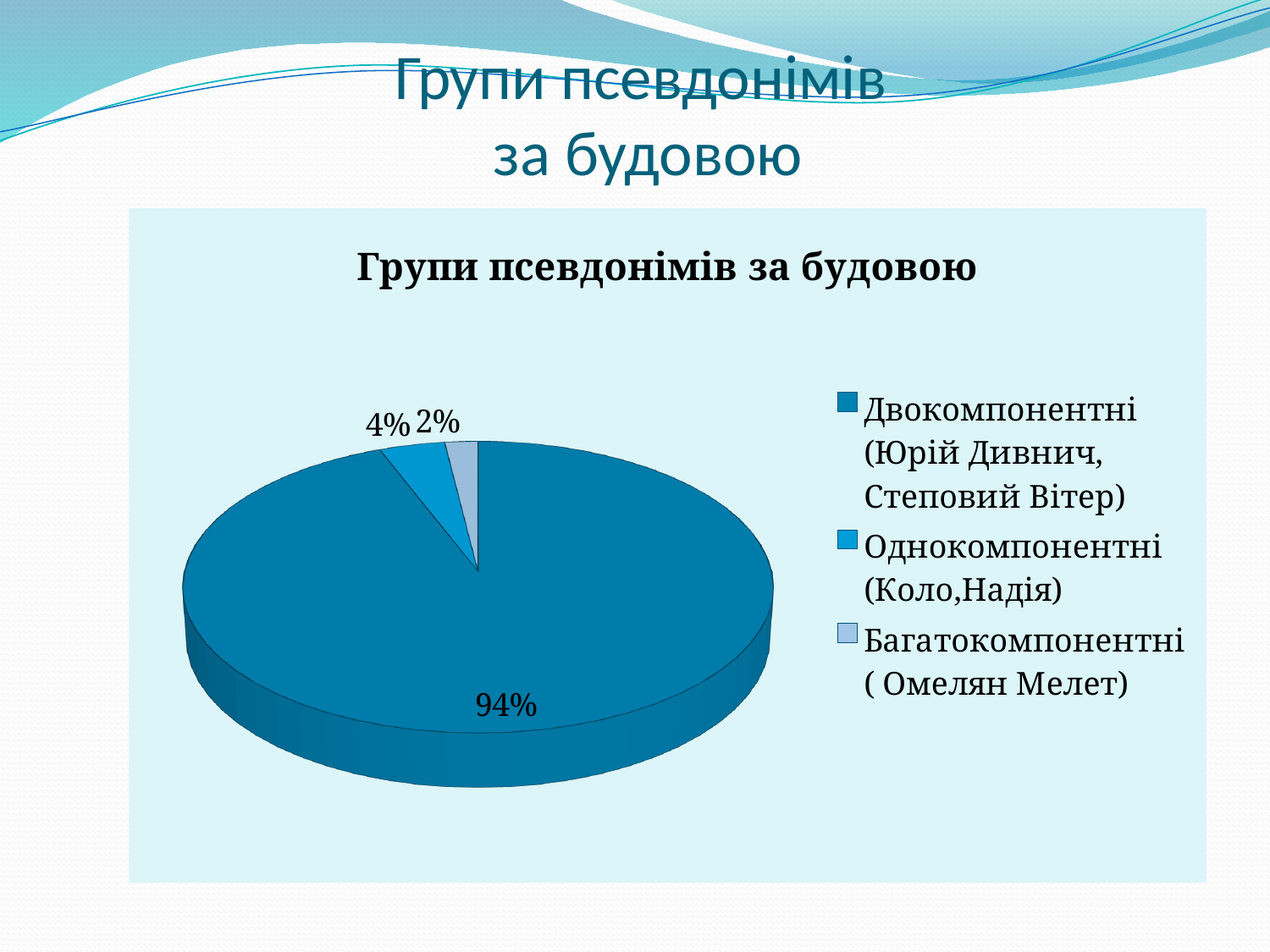
Which category has the largest slice of the pie? Двокомпонентні (Юрій Дивнич, Степовий Вітер) What share of the pie is Багатокомпонентні ( Омелян Мелет)? 2% Which legend entry is shown with the lightest blue colour? Багатокомпонентні ( Омелян Мелет) How many slices does the pie chart have? 3 What kind of chart is shown on the slide? pie chart What is the title of the chart? Групи псевдонімів за будовою What share of the pie is Двокомпонентні (Юрій Дивнич, Степовий Вітер)? 94% Which category has the smallest slice of the pie? Багатокомпонентні ( Омелян Мелет) What is the difference in percentage points between Двокомпонентні and Однокомпонентні? 90 What is the difference in percentage points between Однокомпонентні and Багатокомпонентні? 2 What share of the pie is Однокомпонентні (Коло,Надія)? 4% Which is larger, the share for Однокомпонентні or the share for Багатокомпонентні? Однокомпонентні